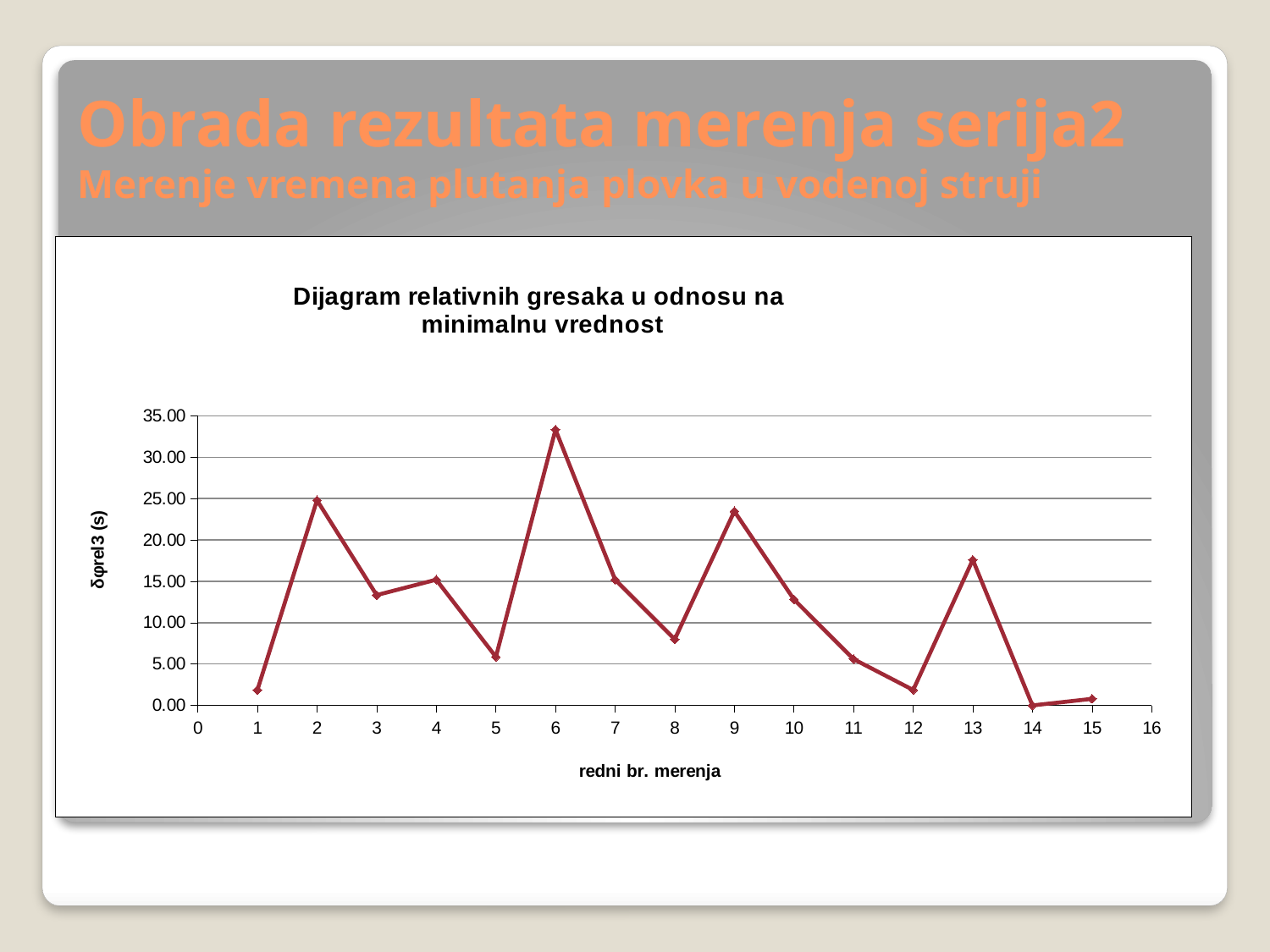
Is the value for measurement 13 greater or less than 20.00? less Is the value for measurement 12 greater or less than 5.00? less Is the value for measurement 3 greater or less than 10.00? greater Which has the larger relative error, measurement 1 or measurement 4? measurement 4 What kind of chart is shown on the slide? line chart Which has the larger relative error, measurement 2 or measurement 6? measurement 6 Which measurement number (redni br. merenja) has the highest relative error? 6 What is the label of the x axis of the chart? redni br. merenja How many measurement points are plotted on the chart? 15 Do the values rise or fall from measurement 9 to measurement 12? fall